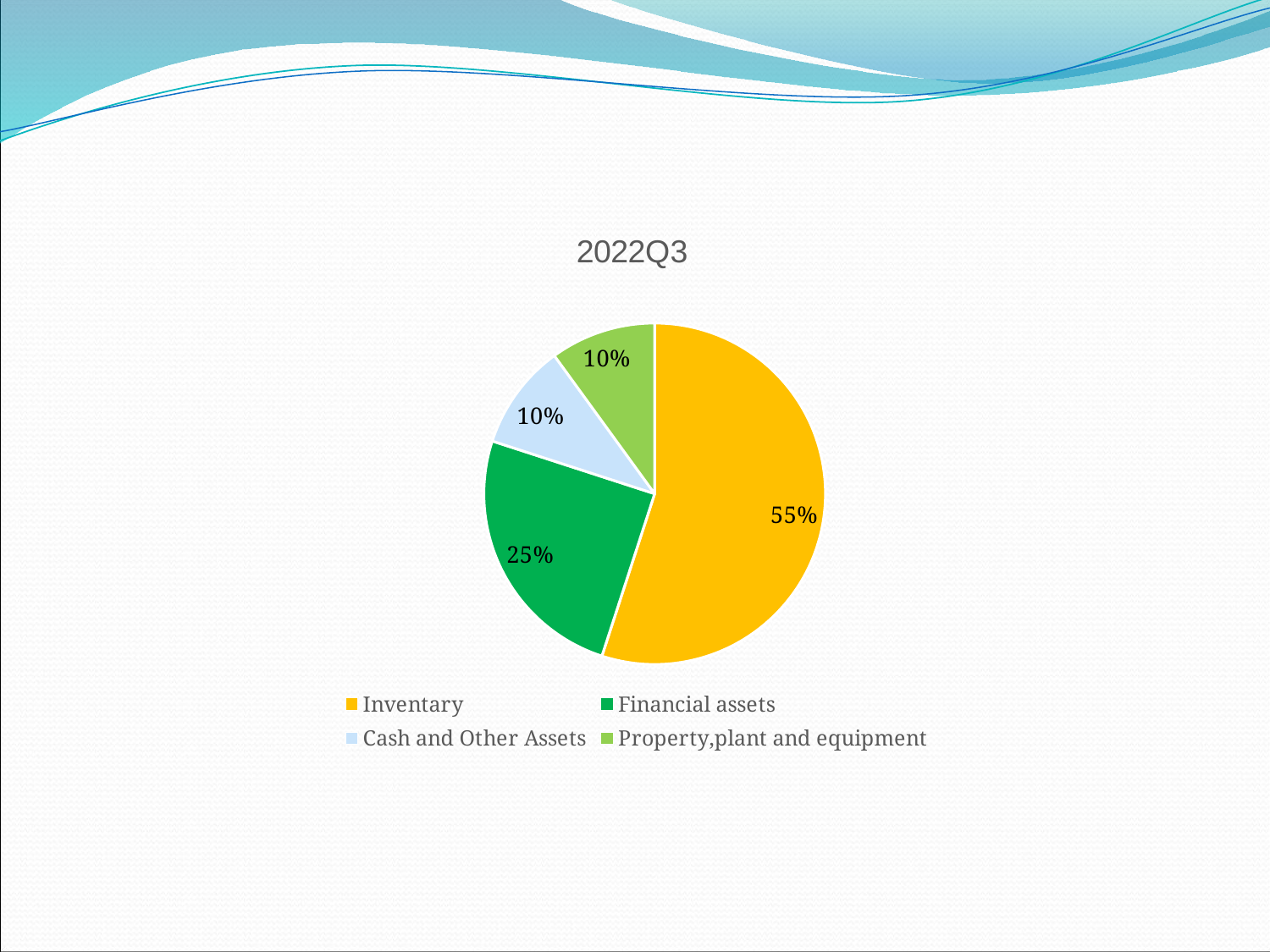
Which category has the largest slice of the pie? Inventary Which is larger, the share for Financial assets or the share for Cash and Other Assets? Financial assets What is the title of the chart? 2022Q3 What share of the pie does Inventary represent? 55% What is the value shown for Financial assets? 25% How many categories does the legend list? 4 What is the combined share of Cash and Other Assets and Property,plant and equipment? 20% What is the difference between the Inventary share and the Financial assets share? 30% What colour is the Inventary slice? Yellow What is the value shown for Property,plant and equipment? 10% What is the value shown for Cash and Other Assets? 10% What type of chart is shown on the slide? Pie chart